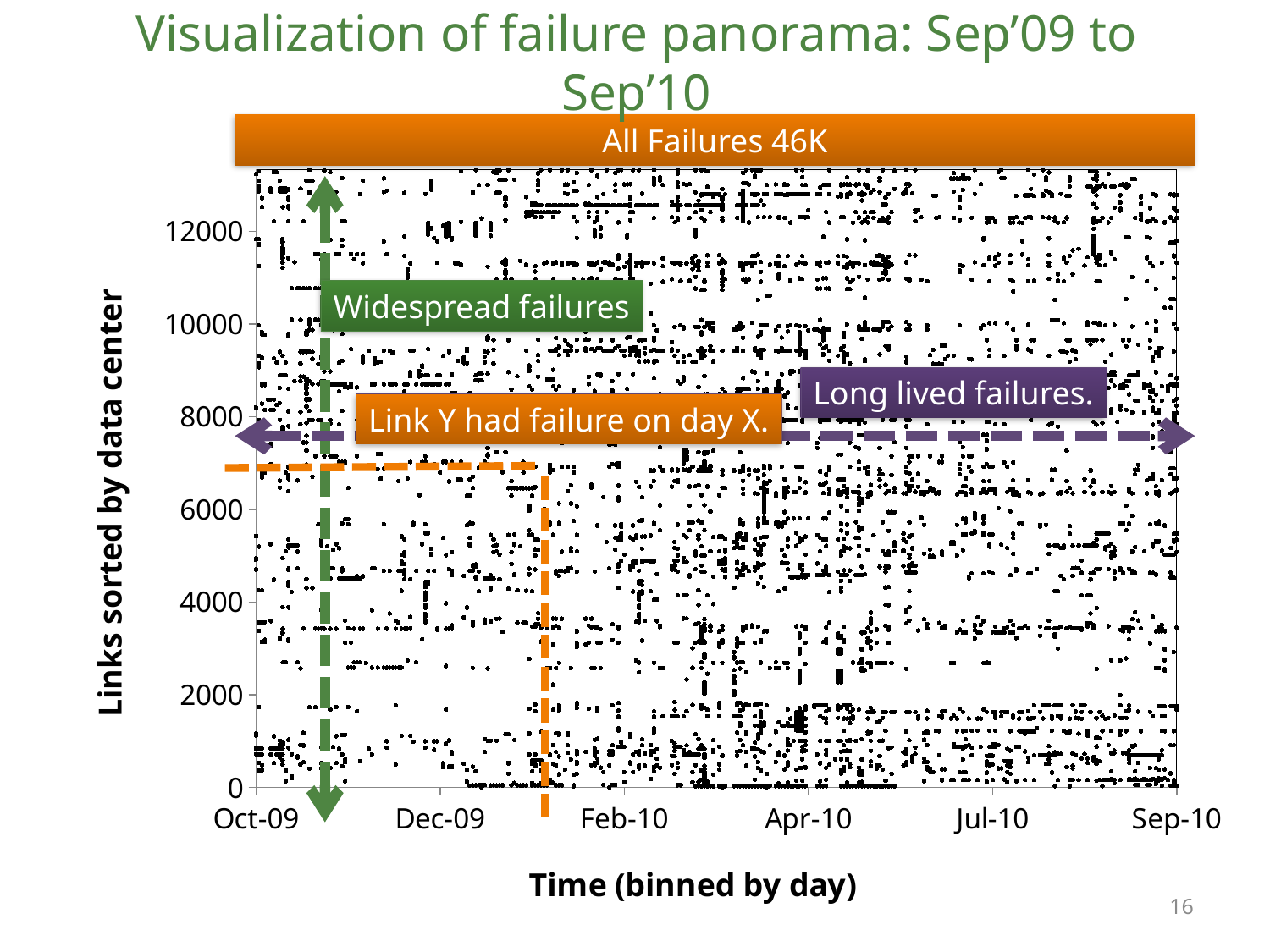
What is the last tick label on the x axis? Sep-10 How many tick labels are shown along the x axis of the chart? 6 What kind of chart is shown on the slide? scatter plot According to the banner above the chart, how many failures are shown in total? 46K What is the first tick label on the x axis? Oct-09 What does the green vertical arrow annotation on the chart say? Widespread failures What is the highest labelled tick value on the y axis? 12000 What is the label of the y axis? Links sorted by data center